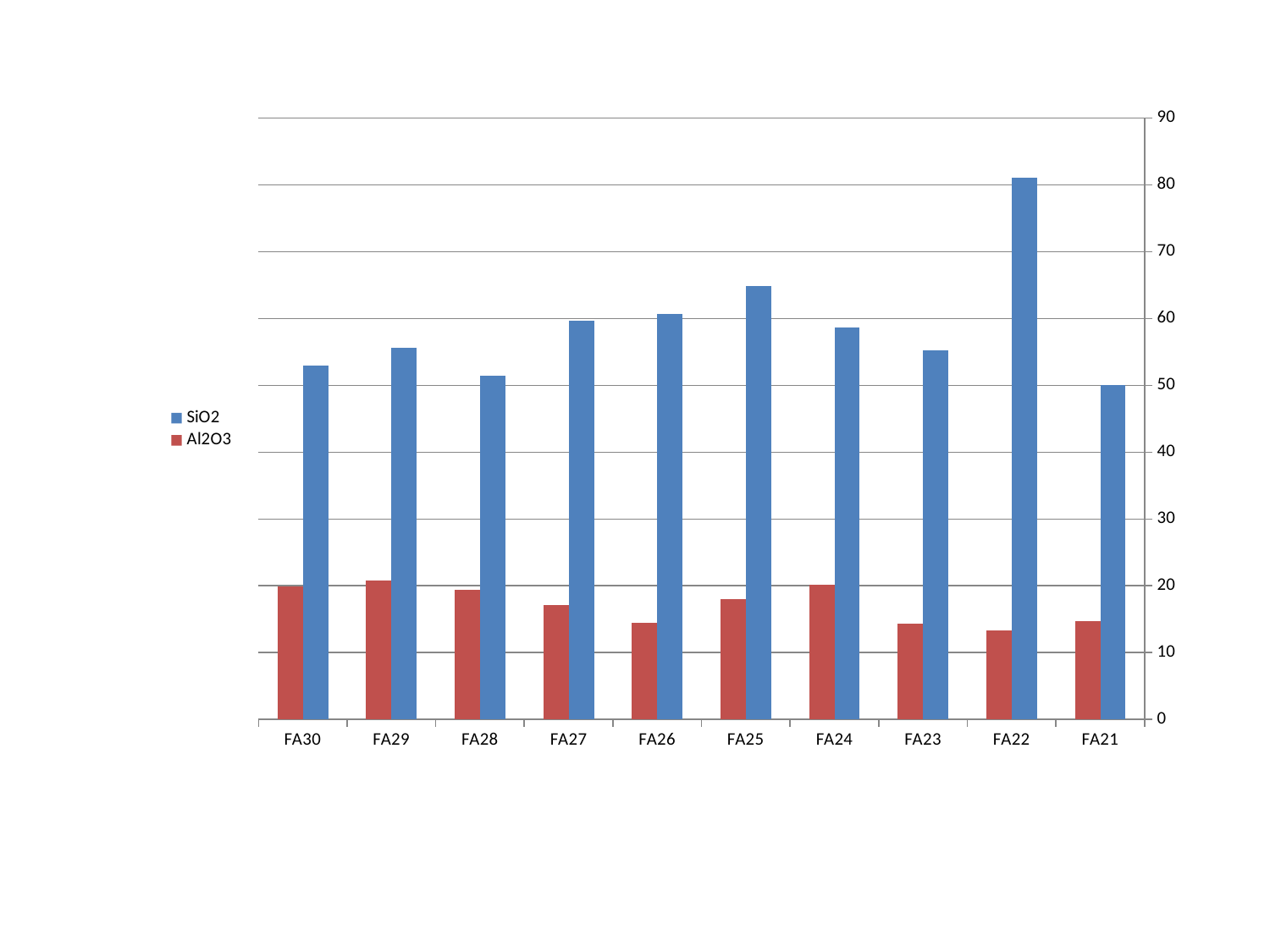
Is the SiO2 value for FA21 greater or less than 60? less For FA27, which series has the larger value, SiO2 or Al2O3? SiO2 How many series does the legend list? 2 What kind of chart is shown on the slide? bar chart Is the SiO2 value for FA22 greater or less than 70? greater Which is larger, the SiO2 value for FA22 or for FA21? FA22 Which category has the highest SiO2 value? FA22 Which is larger, the Al2O3 value for FA30 or for FA22? FA30 Is the Al2O3 value for FA26 greater or less than 20? less How many categories are shown on the x axis? 10 What colour are the SiO2 bars? blue